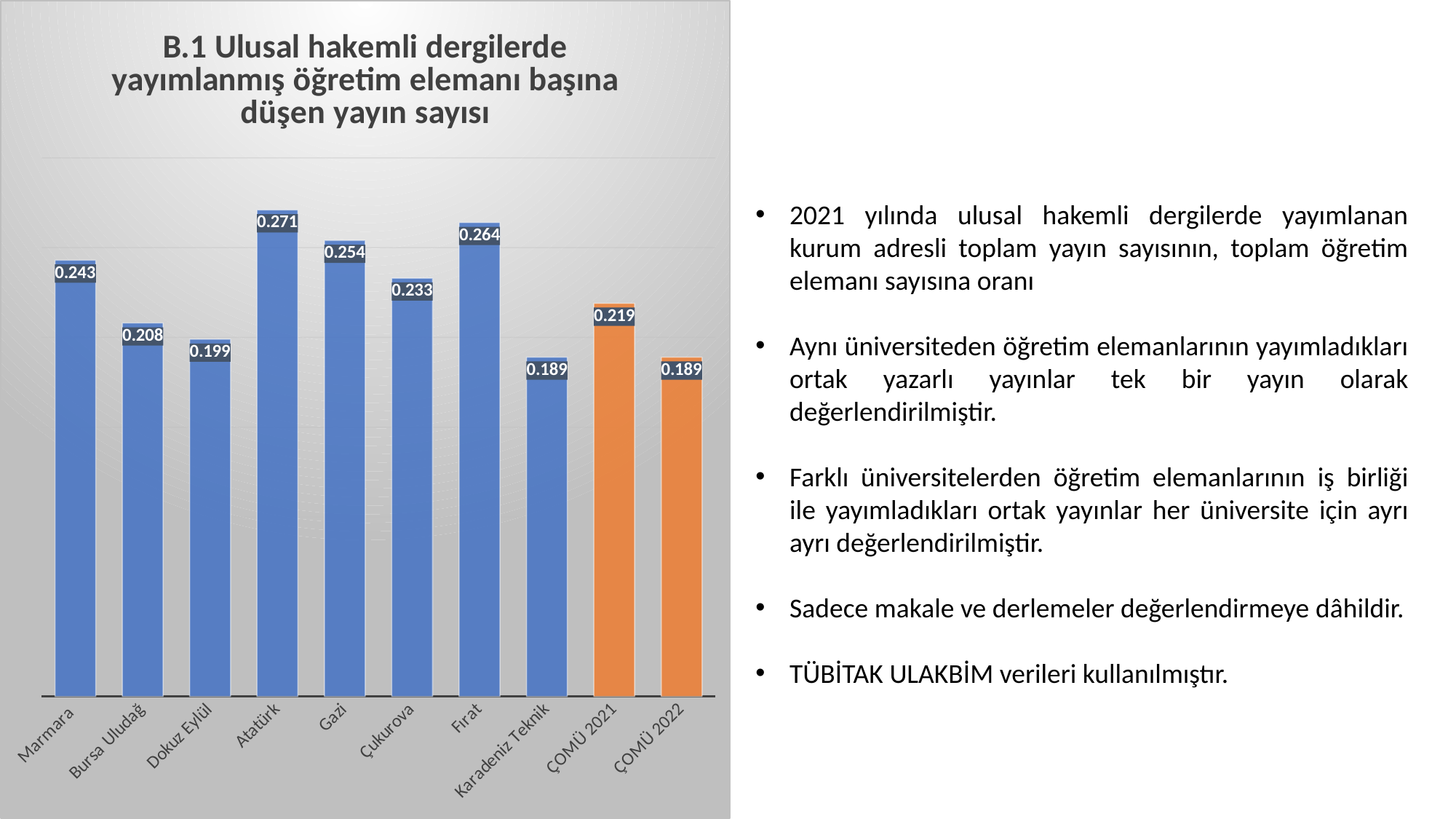
What is the value for Çukurova? 0.233 What is the difference between the values for ÇOMÜ 2021 and ÇOMÜ 2022? 0.030 What is the value for Atatürk? 0.271 What is the value for Dokuz Eylül? 0.199 What colour are the bars for ÇOMÜ 2021 and ÇOMÜ 2022? Orange What kind of chart is shown on the slide? Bar chart How many bars are shown in the chart? 10 Which is larger, the value for Marmara or the value for Bursa Uludağ? Marmara What is the value for ÇOMÜ 2022? 0.189 Which is larger, the value for Gazi or the value for Çukurova? Gazi What is the difference between the values for Atatürk and Marmara? 0.028 Which university has the highest value? Atatürk